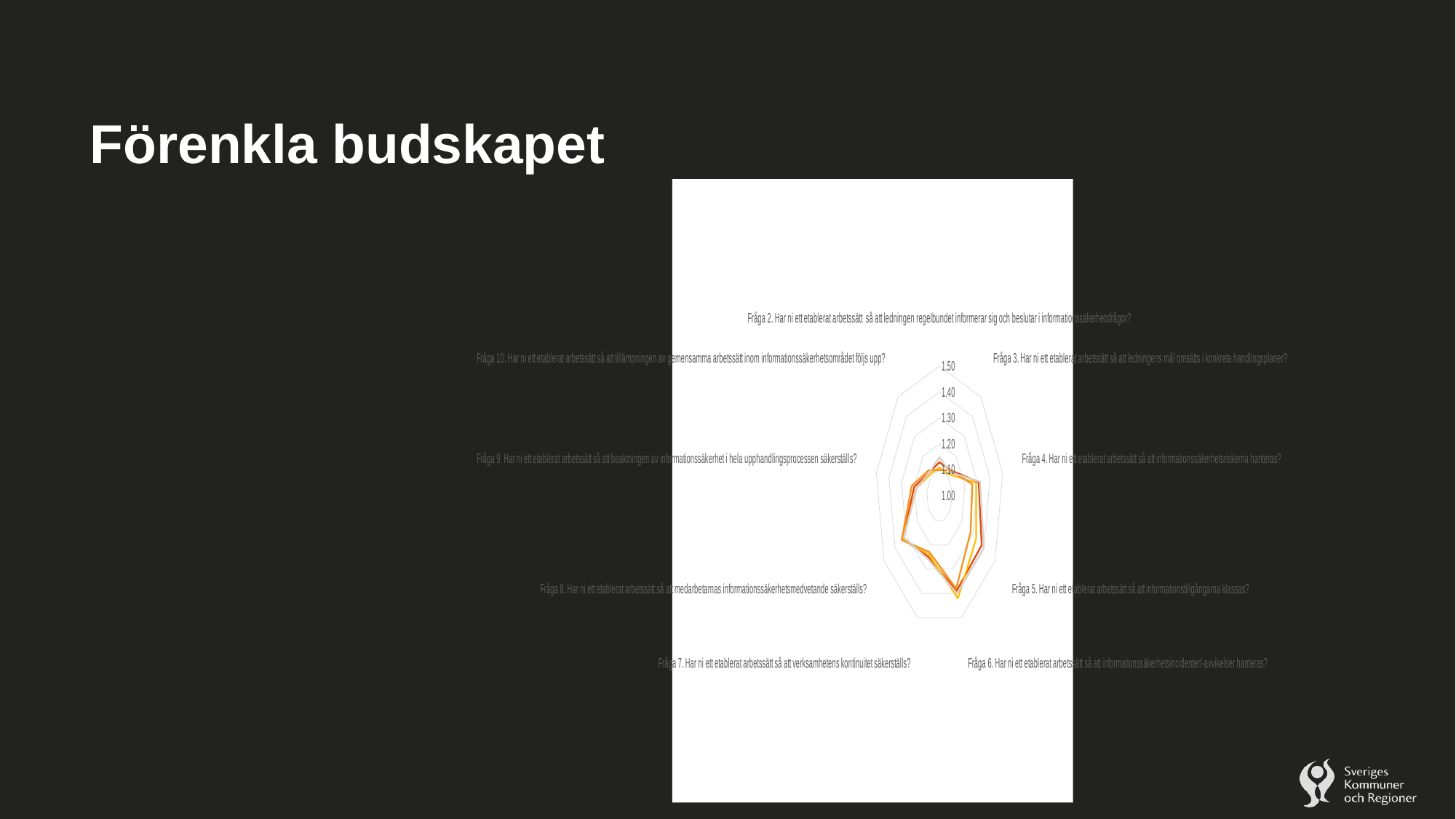
What kind of chart is shown on the slide? Radar chart Is the value for Fråga 6 greater or less than 1.20? greater Is the value for Fråga 8 greater or less than 1.10? greater What is the lowest value shown on the radar chart's axis scale? 1.00 Which has the larger value, Fråga 5 or Fråga 2? Fråga 5 Is the value for Fråga 5 greater or less than 1.10? greater How many categories (questions) are plotted on the radar chart? 9 Which has the larger value, Fråga 6 or Fråga 3? Fråga 6 What is the highest value shown on the radar chart's axis scale? 1.50 Which category has the highest value on the radar chart? Fråga 6